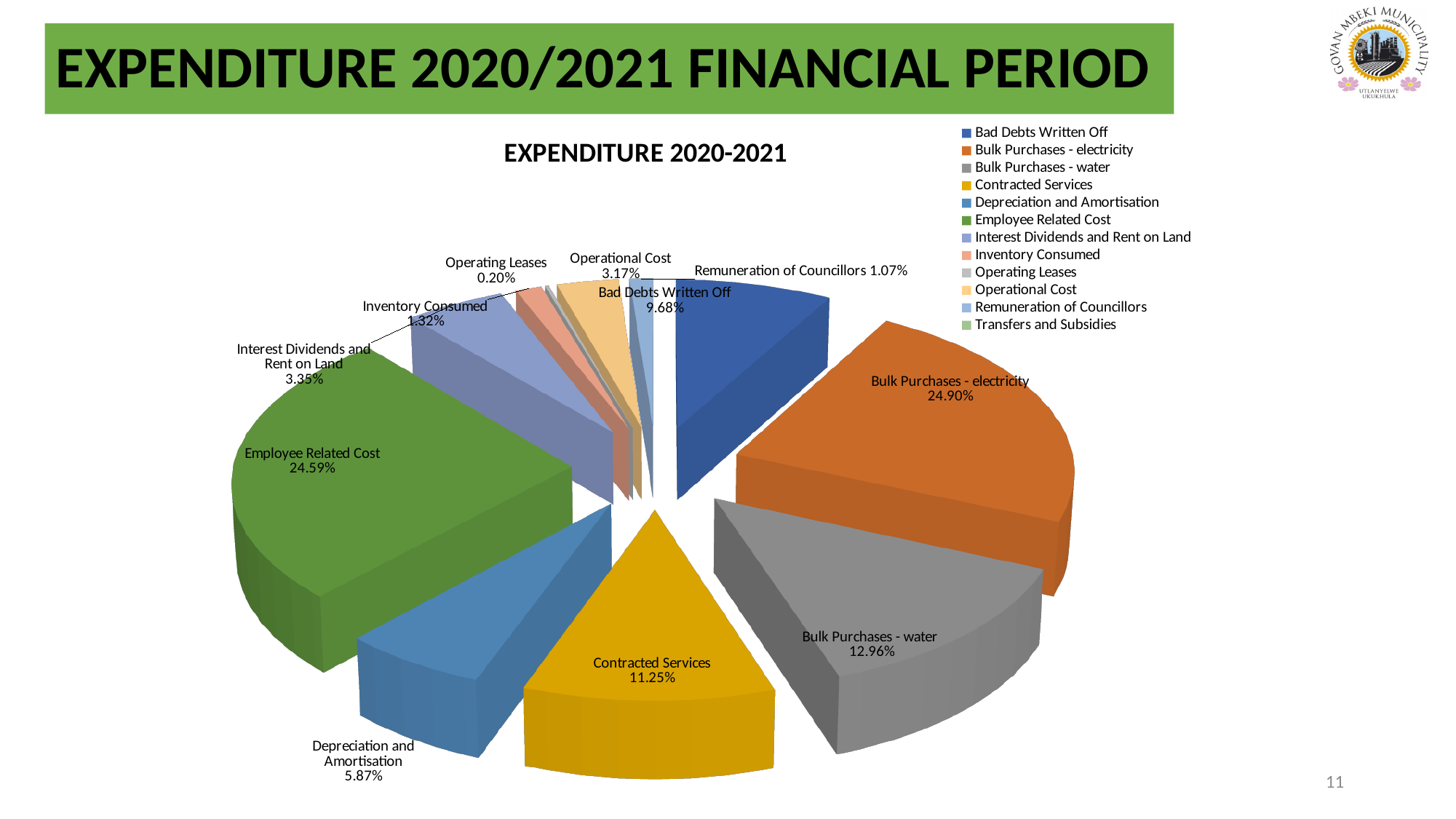
How many entries does the chart legend list? 12 What share of expenditure is Employee Related Cost? 24.59% What percentage is shown for Bulk Purchases - water? 12.96% What kind of chart is shown on the slide? Pie chart What share of expenditure is Bulk Purchases - electricity? 24.90% What is the title of the chart? EXPENDITURE 2020-2021 What percentage is shown for Contracted Services? 11.25% What is the difference between the shares of Bulk Purchases - electricity and Employee Related Cost? 0.31% What percentage is shown for Depreciation and Amortisation? 5.87% What percentage is shown for Operating Leases? 0.20% Which is larger, Bad Debts Written Off or Bulk Purchases - water? Bulk Purchases - water Which category has the largest share of expenditure? Bulk Purchases - electricity